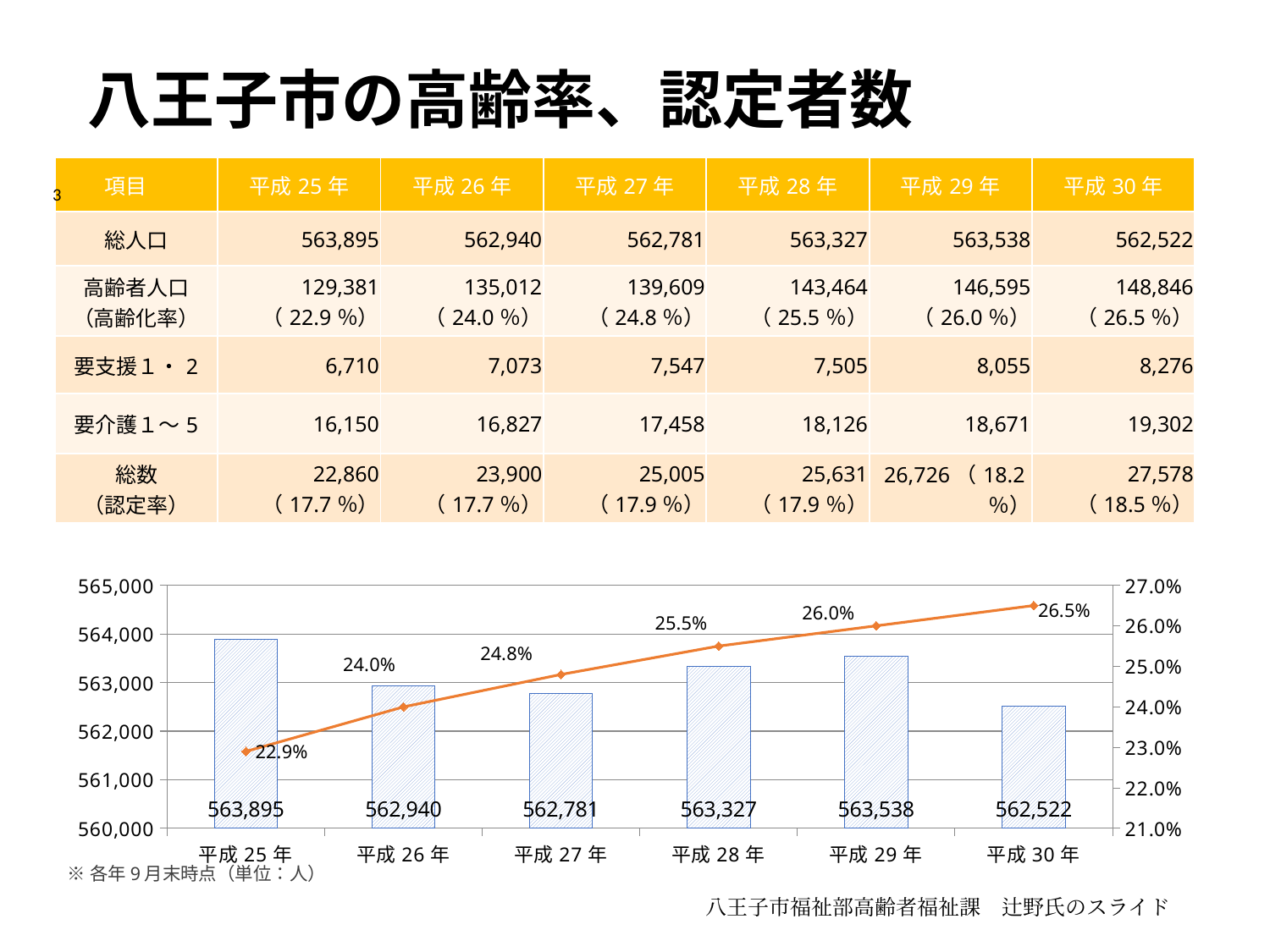
What is the difference between the bar values for 平成25年 and 平成30年? 1,373 What is the highest tick value shown on the right-hand axis of the chart? 27.0% How many years are shown on the x axis of the chart? 6 Which year has the tallest bar in the chart? 平成25年 What is the total population value shown for 平成28年 in the bar chart? 563,327 Which year has the shortest bar in the chart? 平成30年 Does the line plotted on the chart rise or fall from 平成25年 to 平成30年? rises What kind of chart is shown at the bottom of the slide? A bar chart combined with a line chart What percentage does the line show for 平成27年? 24.8% Is the bar value for 平成27年 greater or less than 563,000? less Which bar is taller, 平成26年 or 平成29年? 平成29年 By how many percentage points does the line value increase from 平成25年 to 平成30年? 3.6 percentage points